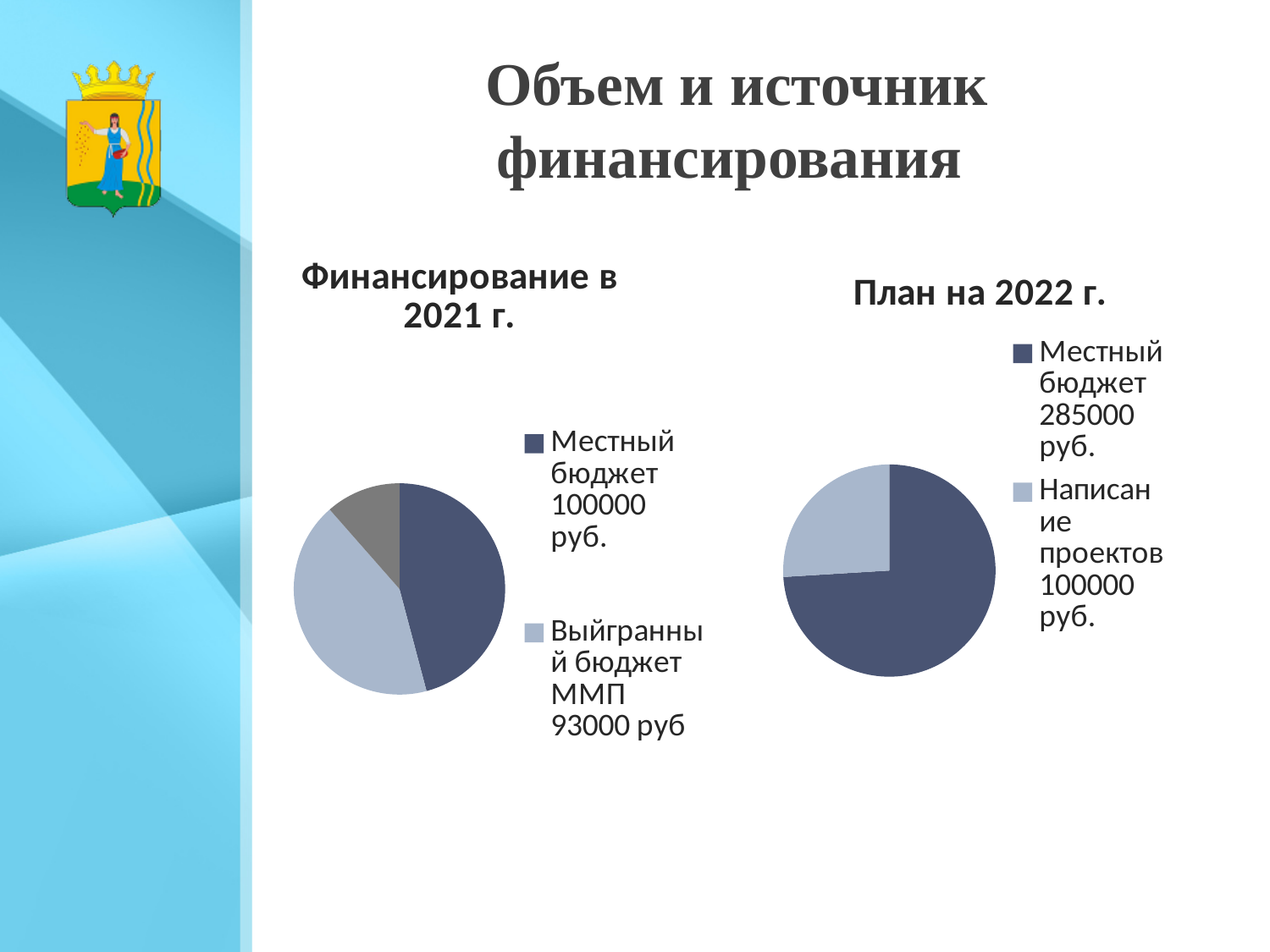
What type of chart is used for "Финансирование в 2021 г."? pie chart In the "Финансирование в 2021 г." chart, what is the value for Местный бюджет? 100000 руб. In the "План на 2022 г." chart, what is the value for Местный бюджет? 285000 руб. In the "План на 2022 г." chart, what is the value for Написание проектов? 100000 руб. What is the title of the pie chart on the right side of the slide? План на 2022 г. In the "План на 2022 г." chart, which category has the largest slice? Местный бюджет How many slices does the "Финансирование в 2021 г." pie chart have? 3 In the "Финансирование в 2021 г." chart, which is larger: Местный бюджет or Выйгранный бюджет ММП? Местный бюджет How many entries does the legend of the "План на 2022 г." chart list? 2 In the "Финансирование в 2021 г." chart, what is the value for Выйгранный бюджет ММП? 93000 руб In the "План на 2022 г." chart, what is the difference between Местный бюджет and Написание проектов? 185000 руб. In the "Финансирование в 2021 г." chart, what is the difference between Местный бюджет and Выйгранный бюджет ММП? 7000 руб.